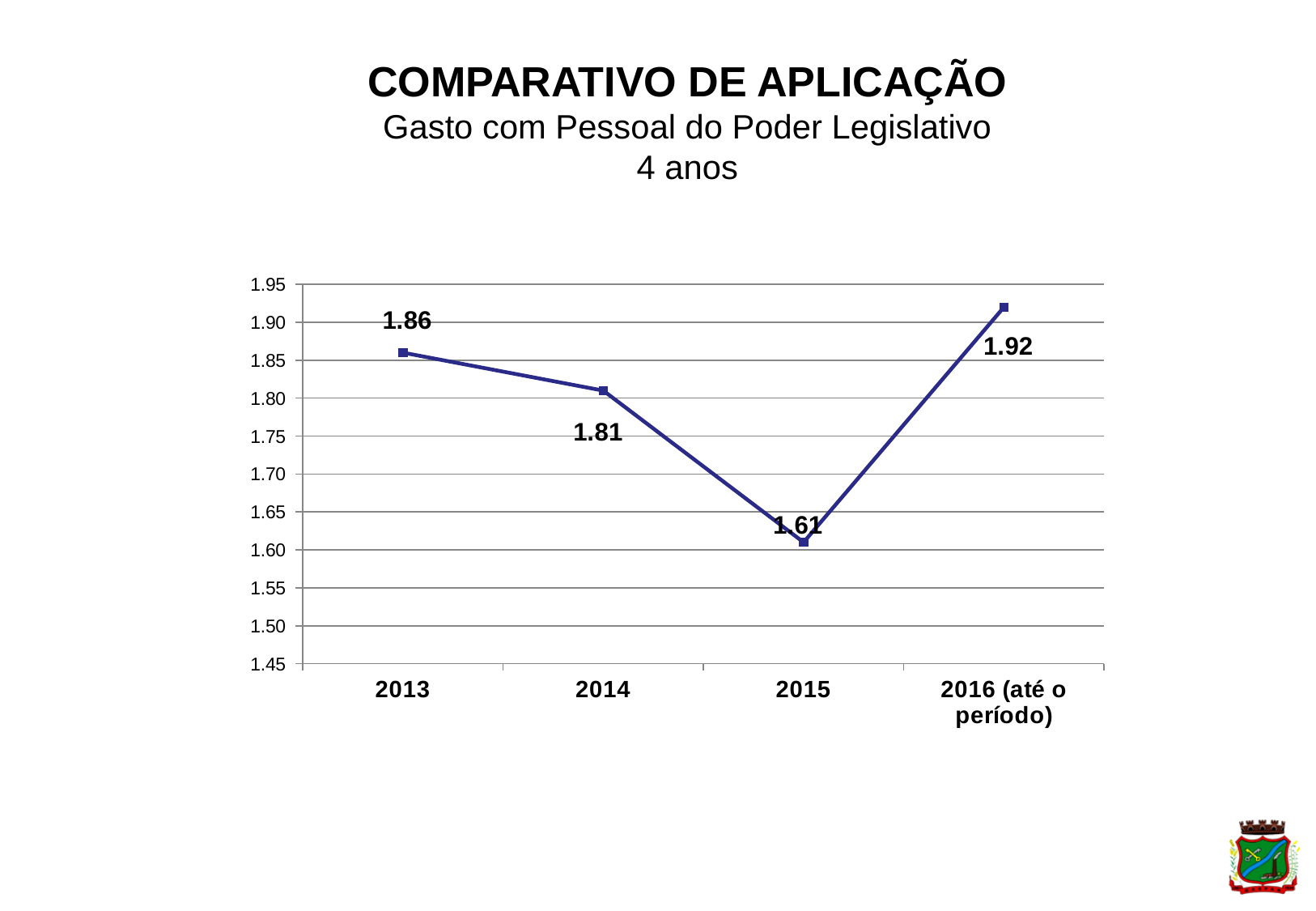
What is the value for 2014? 1.81 What is the value for 2016 (até o período)? 1.92 Which year has the lowest value? 2015 Which year has the highest value? 2016 (até o período) Do the values rise or fall from 2013 to 2015? fall How many data points are plotted on the chart? 4 What is the difference between the values for 2013 and 2015? 0.25 What is the value for 2015? 1.61 What is the difference between the values for 2016 (até o período) and 2014? 0.11 What kind of chart is shown on the slide? line chart Which is larger, the value for 2013 or the value for 2014? 2013 What is the value for 2013? 1.86